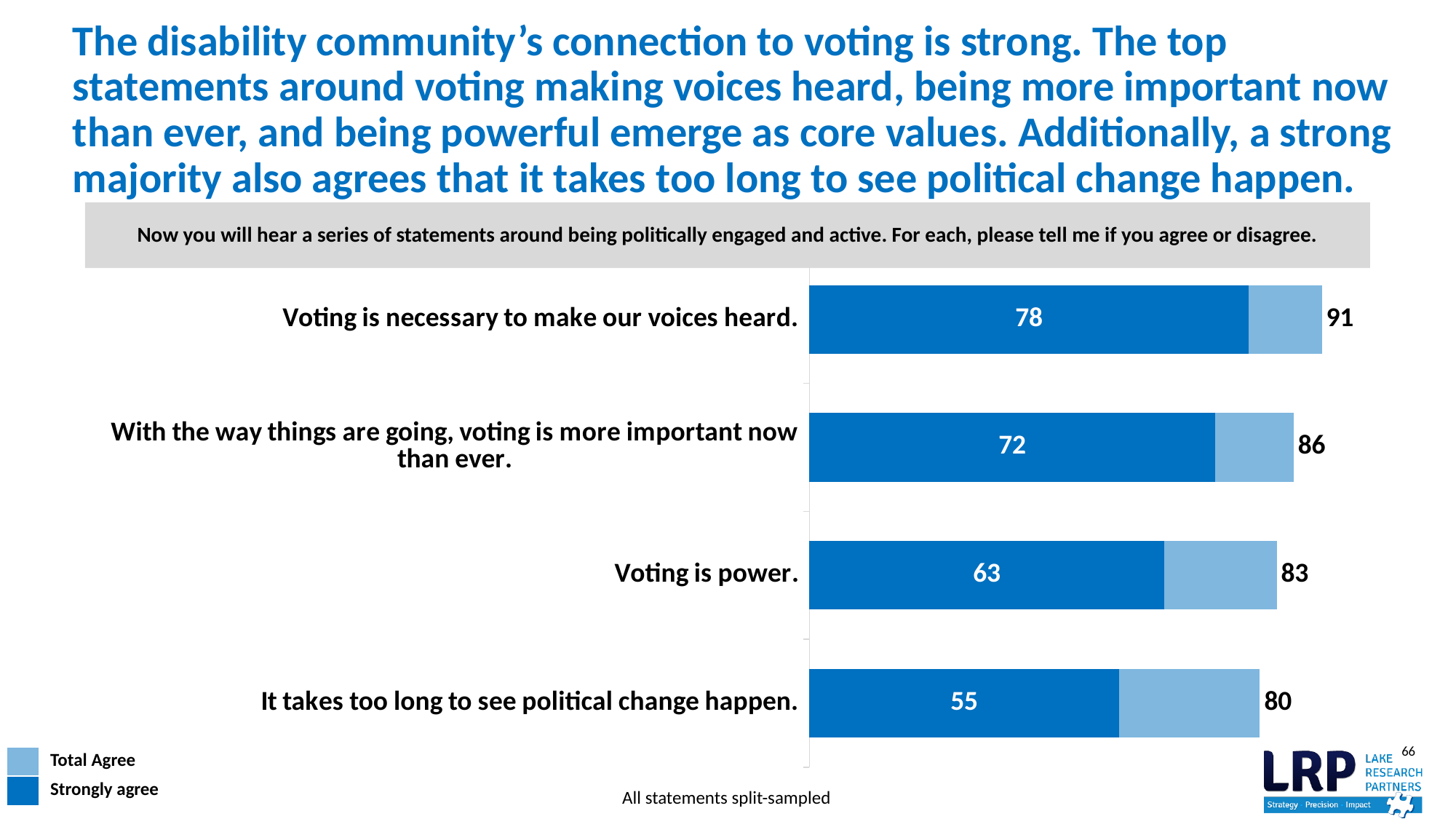
What is the Total Agree value for "Voting is power."? 83 Which statement has the lowest Strongly agree value? It takes too long to see political change happen. What is the difference between the Total Agree and Strongly agree values for "Voting is power."? 20 What kind of chart is shown on the slide? Bar chart Which legend entry is shown in the darker blue colour? Strongly agree Which is larger: the Strongly agree value for "Voting is power." or for "It takes too long to see political change happen."? Voting is power. What is the Strongly agree value for "It takes too long to see political change happen."? 55 How many statements are shown in the chart? 4 How many series does the legend list? 2 What is the Total Agree value for "With the way things are going, voting is more important now than ever."? 86 What is the Strongly agree value for "Voting is necessary to make our voices heard."? 78 Which statement has the highest Total Agree value? Voting is necessary to make our voices heard.